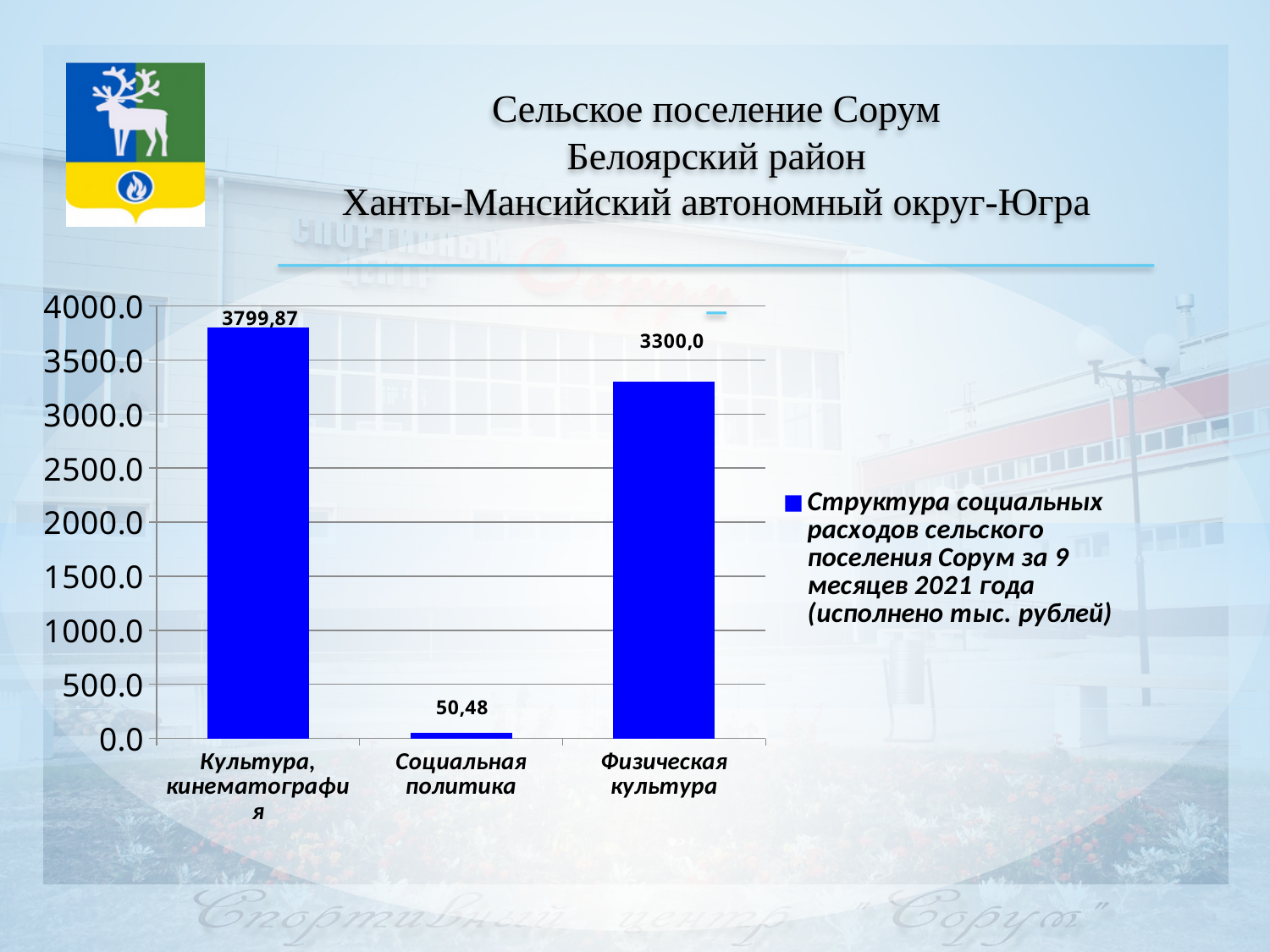
What is the value for Культура, кинематография? 3799,87 What is the legend entry of the chart? Структура социальных расходов сельского поселения Сорум за 9 месяцев 2021 года (исполнено тыс. рублей) Which category has the highest value? Культура, кинематография Is the value for Физическая культура greater or less than 3500.0? less How many categories are shown on the x axis? 3 What is the difference between the values for Культура, кинематография and Физическая культура? 499,87 What is the difference between the values for Физическая культура and Социальная политика? 3249,52 What kind of chart is shown on the slide? bar chart What is the value for Физическая культура? 3300,0 Which category has the lowest value? Социальная политика What is the value for Социальная политика? 50,48 Which is larger, the value for Физическая культура or the value for Социальная политика? Физическая культура